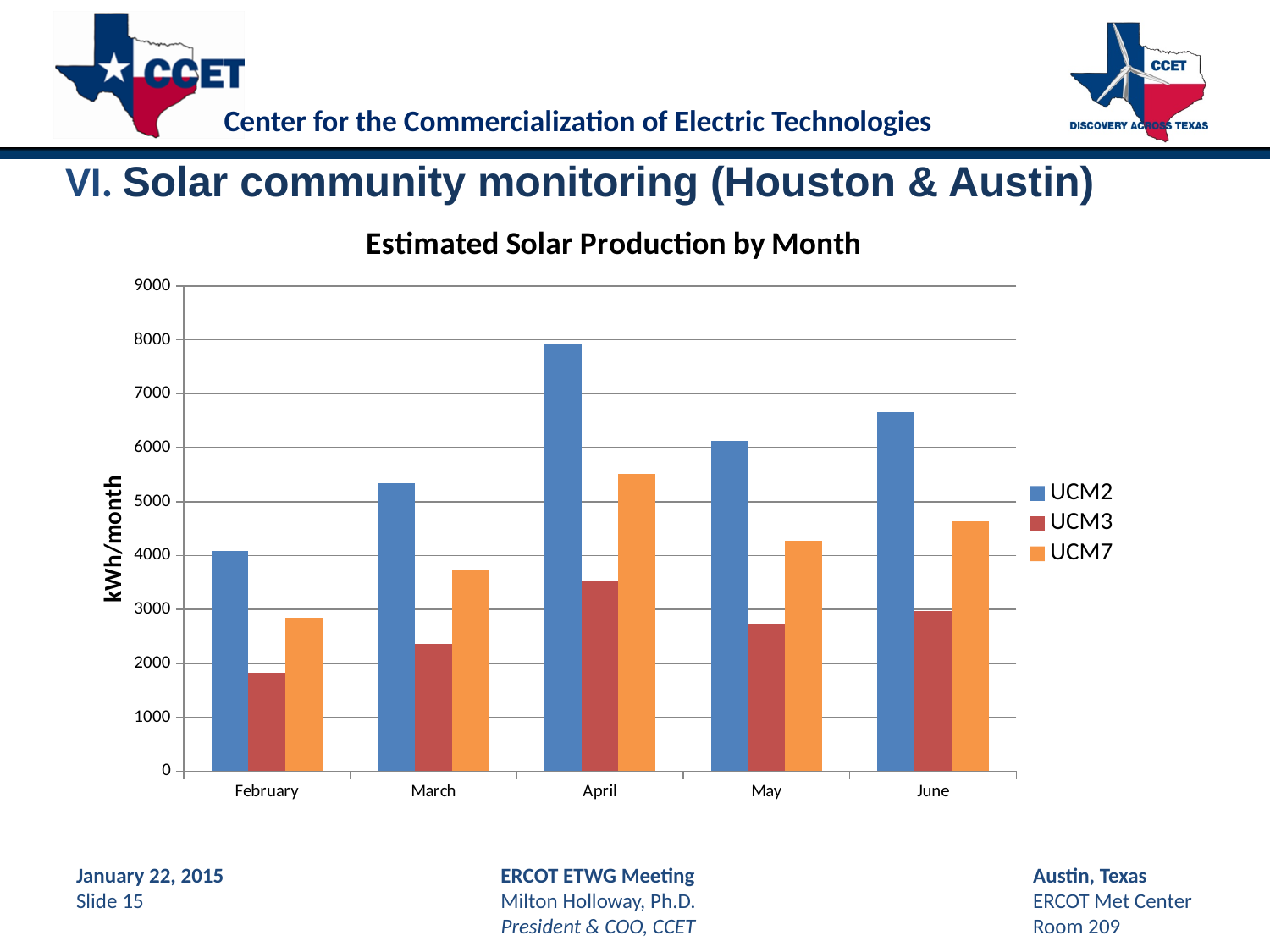
Is the value for UCM3 in February greater or less than 2000? less What kind of chart is shown on the slide? bar chart Which is larger: UCM2 in May or UCM7 in June? UCM2 in May How many series does the legend list? 3 What is the label on the y axis of the chart? kWh/month Is the value for UCM7 in March greater or less than 4000? less In which month is the UCM2 value highest? April How many months are shown on the x axis? 5 Do the UCM2 values rise or fall from February to April? rise In which month is the UCM3 value lowest? February Is the value for UCM2 in April greater or less than 7000? greater Which series has the highest value in every month? UCM2